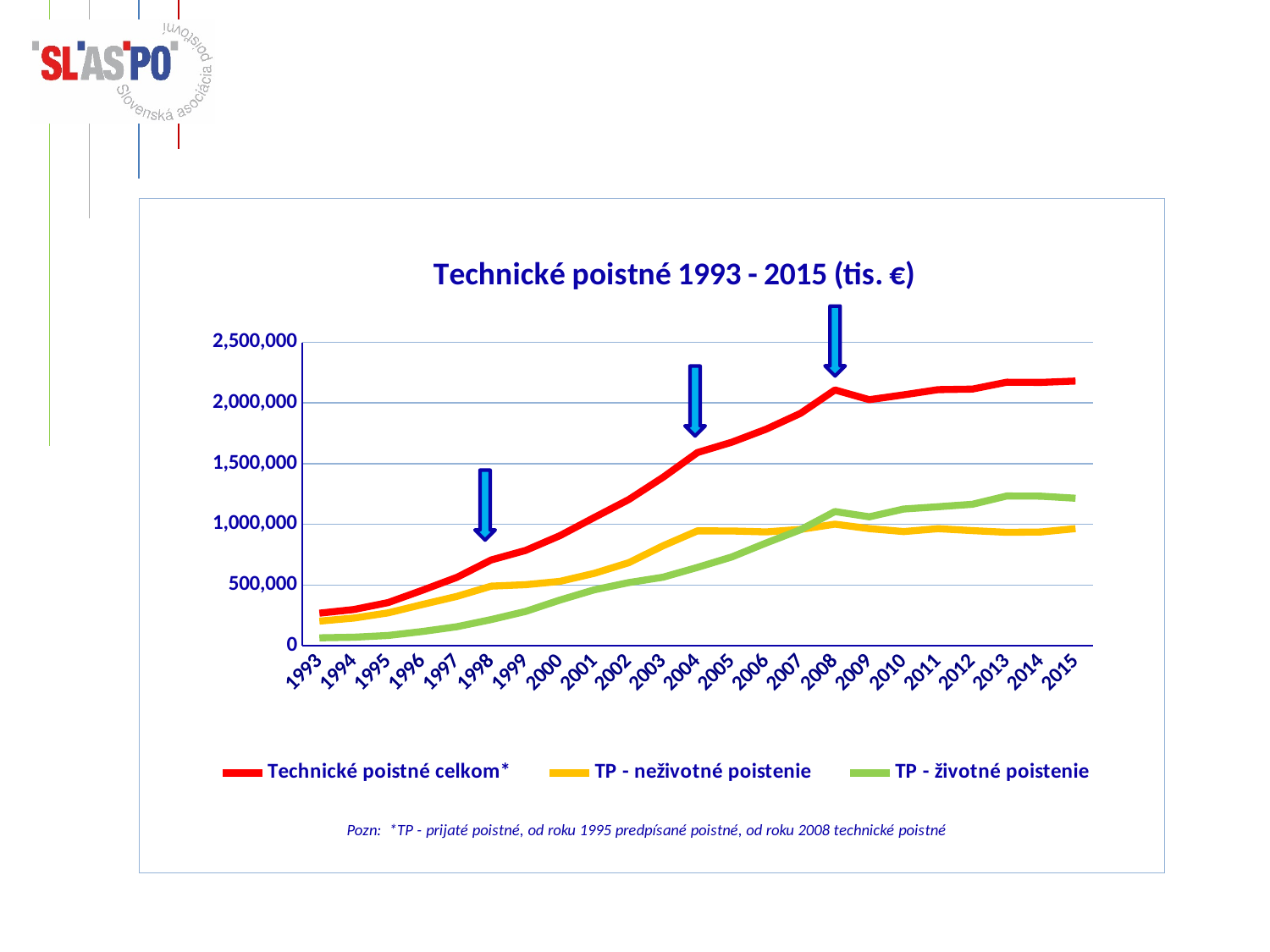
What kind of chart is shown on the slide? line chart In 2015, which is larger: TP - neživotné poistenie or TP - životné poistenie? TP - životné poistenie What is the title of the chart? Technické poistné 1993 - 2015 (tis. €) In 1998, which is larger: TP - neživotné poistenie or TP - životné poistenie? TP - neživotné poistenie Is the value for Technické poistné celkom* in 2003 greater or less than 1,500,000? less How many series does the legend list? 3 Is the value for TP - životné poistenie in 2015 greater or less than 1,000,000? greater In which year is Technické poistné celkom* lowest? 1993 Is the value for Technické poistné celkom* in 1993 greater or less than 500,000? less How many years are shown on the x axis? 23